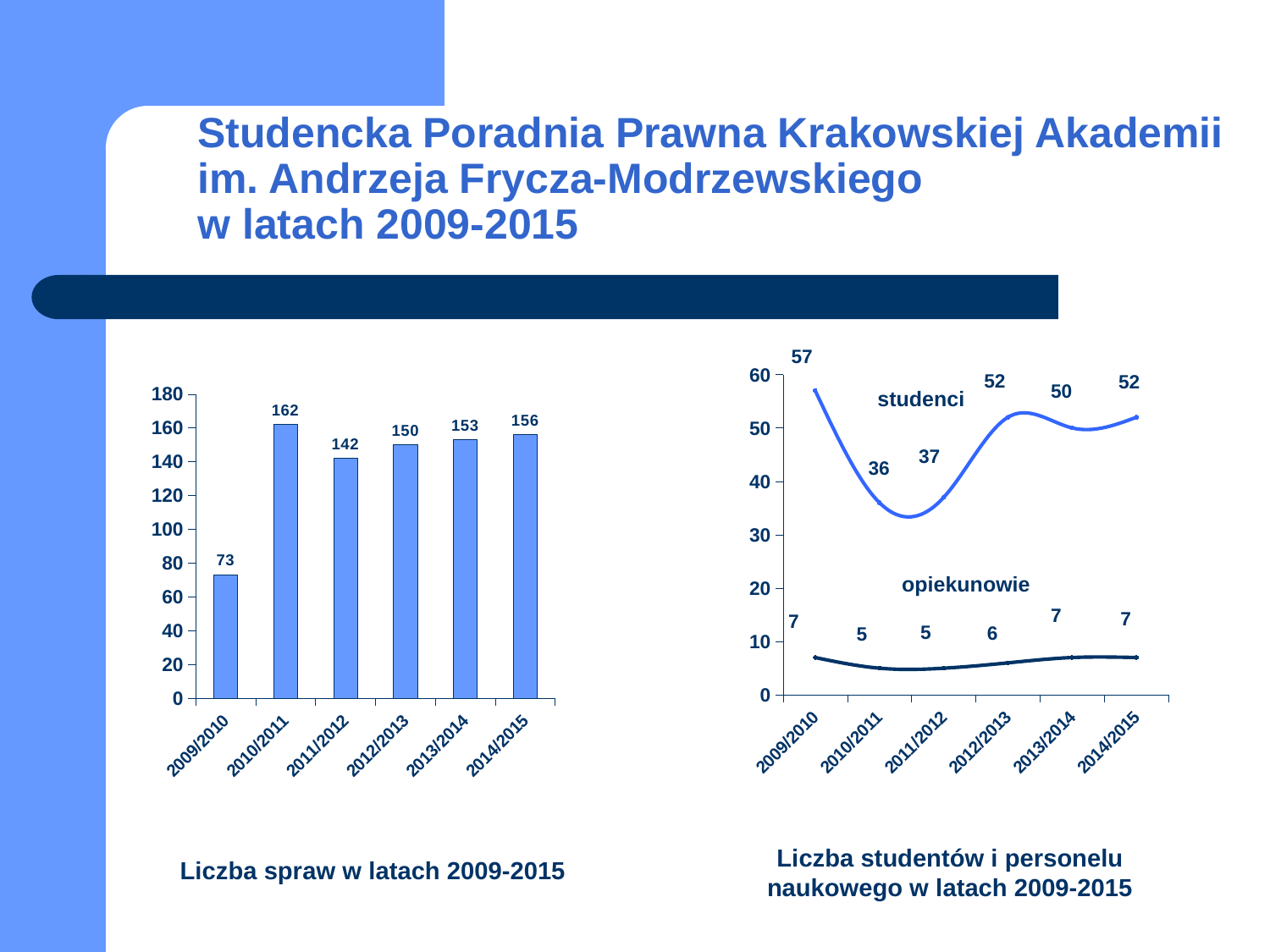
In the left chart (Liczba spraw w latach 2009-2015), what is the difference between the values for 2010/2011 and 2009/2010? 89 In the right chart (Liczba studentów i personelu naukowego), what is the value for opiekunowie in 2012/2013? 6 What kind of chart is the right chart (Liczba studentów i personelu naukowego)? line chart In the left chart (Liczba spraw w latach 2009-2015), which year has the highest value? 2010/2011 What kind of chart is the left chart (Liczba spraw w latach 2009-2015)? bar chart In the right chart (Liczba studentów i personelu naukowego), what is the value for studenci in 2009/2010? 57 In the left chart (Liczba spraw w latach 2009-2015), what is the value for 2011/2012? 142 In the right chart (Liczba studentów i personelu naukowego), what is the difference between studenci and opiekunowie in 2014/2015? 45 In the left chart (Liczba spraw w latach 2009-2015), how many years are shown on the x axis? 6 In the left chart (Liczba spraw w latach 2009-2015), which year has the lowest value? 2009/2010 In the right chart (Liczba studentów i personelu naukowego), which year has the lowest value for studenci? 2010/2011 In the right chart (Liczba studentów i personelu naukowego), how many series are plotted? 2